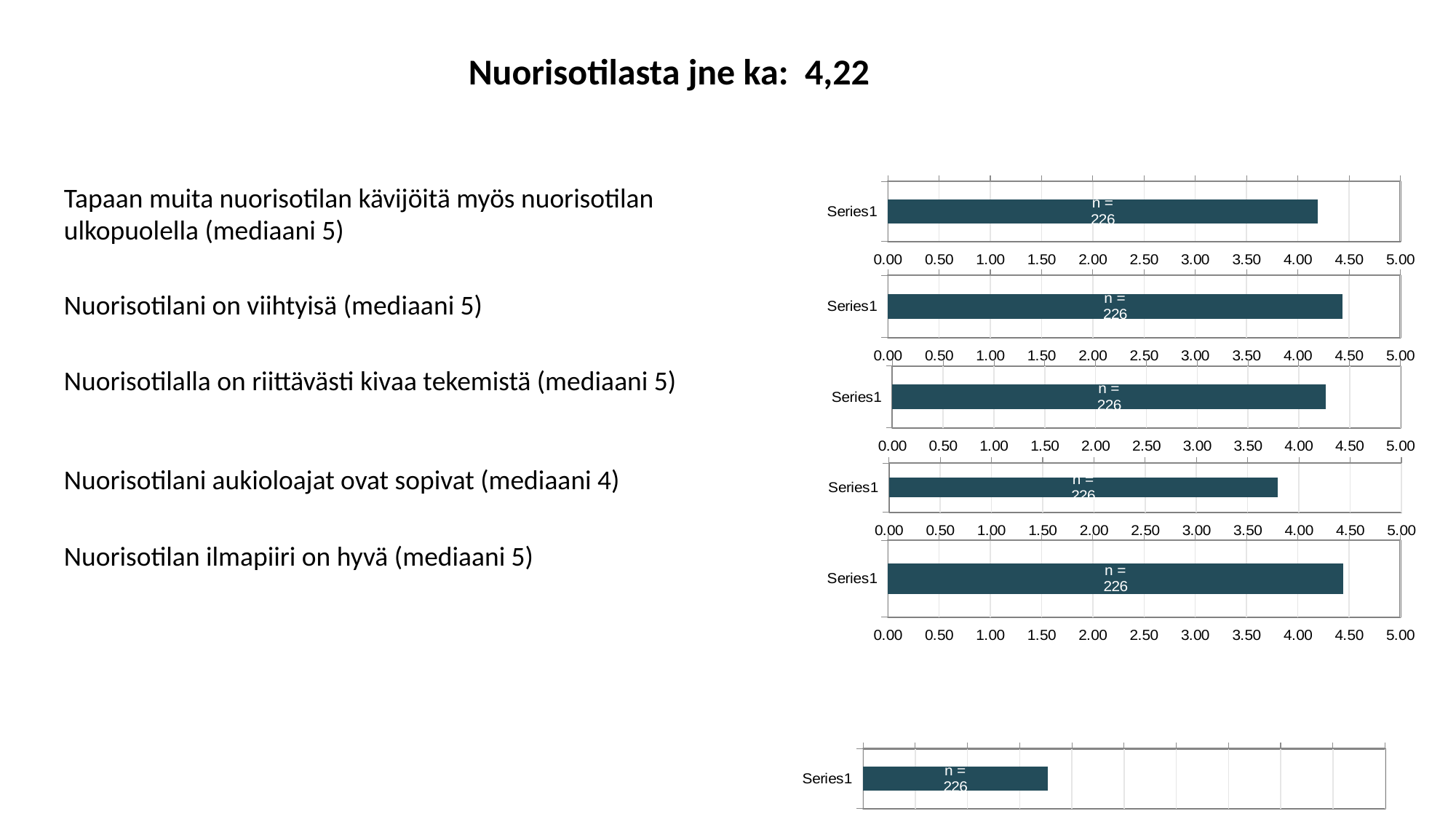
In the second chart from the top on the right, is the value for Series1 greater or less than 4.00? greater What kind of chart is the top chart on the right side of the slide? bar chart In the fourth chart from the top on the right, is the value for Series1 greater or less than 4.00? less In the third chart from the top on the right, is the value for Series1 greater or less than 4.50? less What data label is printed on the bar in the fifth chart from the top on the right? n = 226 How many bars does the top chart on the right side of the slide contain? 1 What is the highest value shown on the x axis of the top chart on the right? 5.00 Which has the larger bar: the fourth chart from the top or the fifth chart from the top on the right? the fifth chart from the top